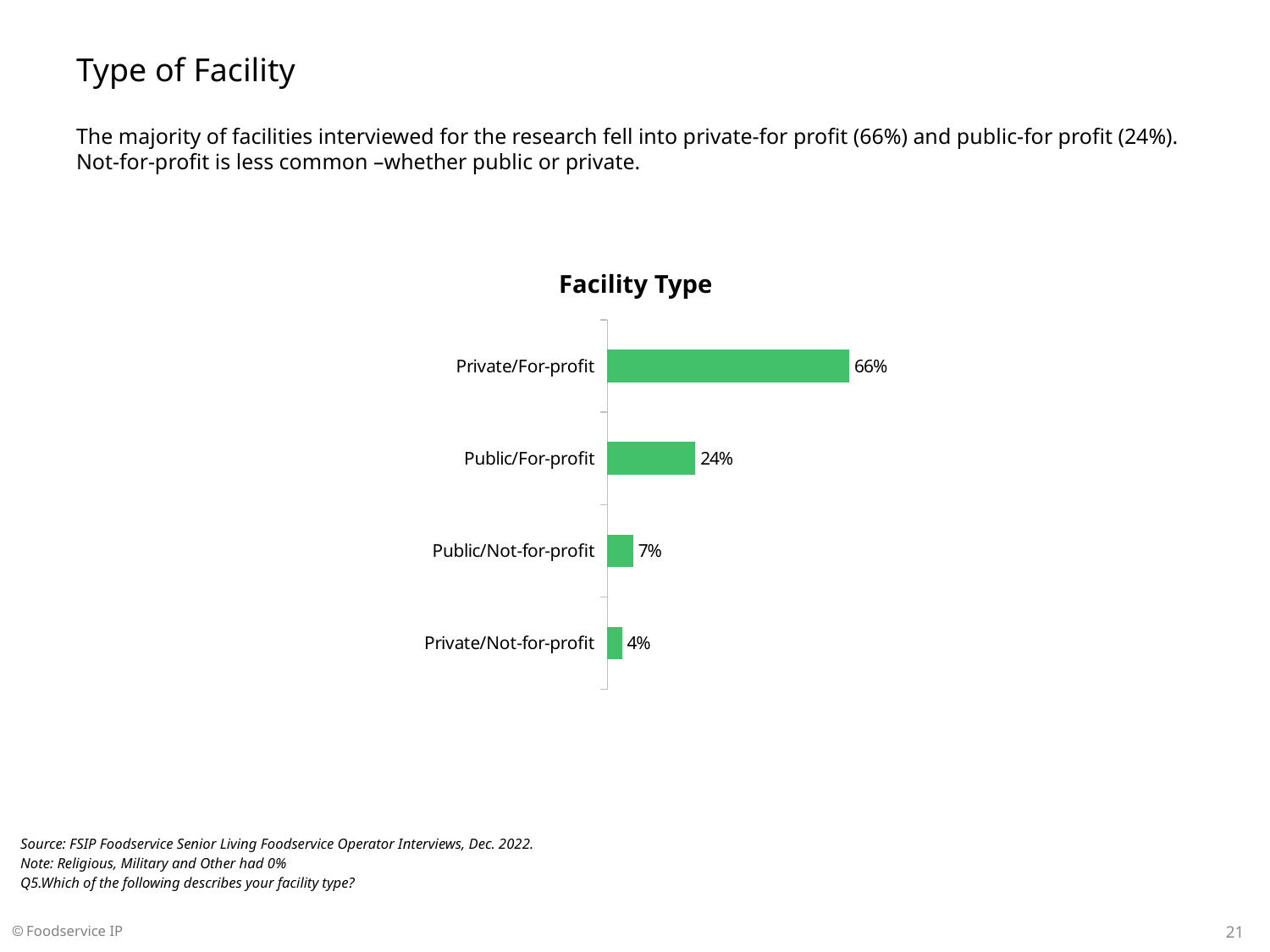
Which facility type has the lowest value? Private/Not-for-profit Which facility type has the highest value? Private/For-profit Which is larger, the value for Public/For-profit or the value for Public/Not-for-profit? Public/For-profit What kind of chart is shown on the slide? Bar chart How many facility types are shown in the chart? 4 What is the value for Private/Not-for-profit? 4% What is the difference between the values for Private/For-profit and Public/For-profit? 42% What is the value for Public/For-profit? 24% What is the value for Private/For-profit? 66% What is the difference between the values for Public/Not-for-profit and Private/Not-for-profit? 3% What is the title of the chart? Facility Type What is the value for Public/Not-for-profit? 7%